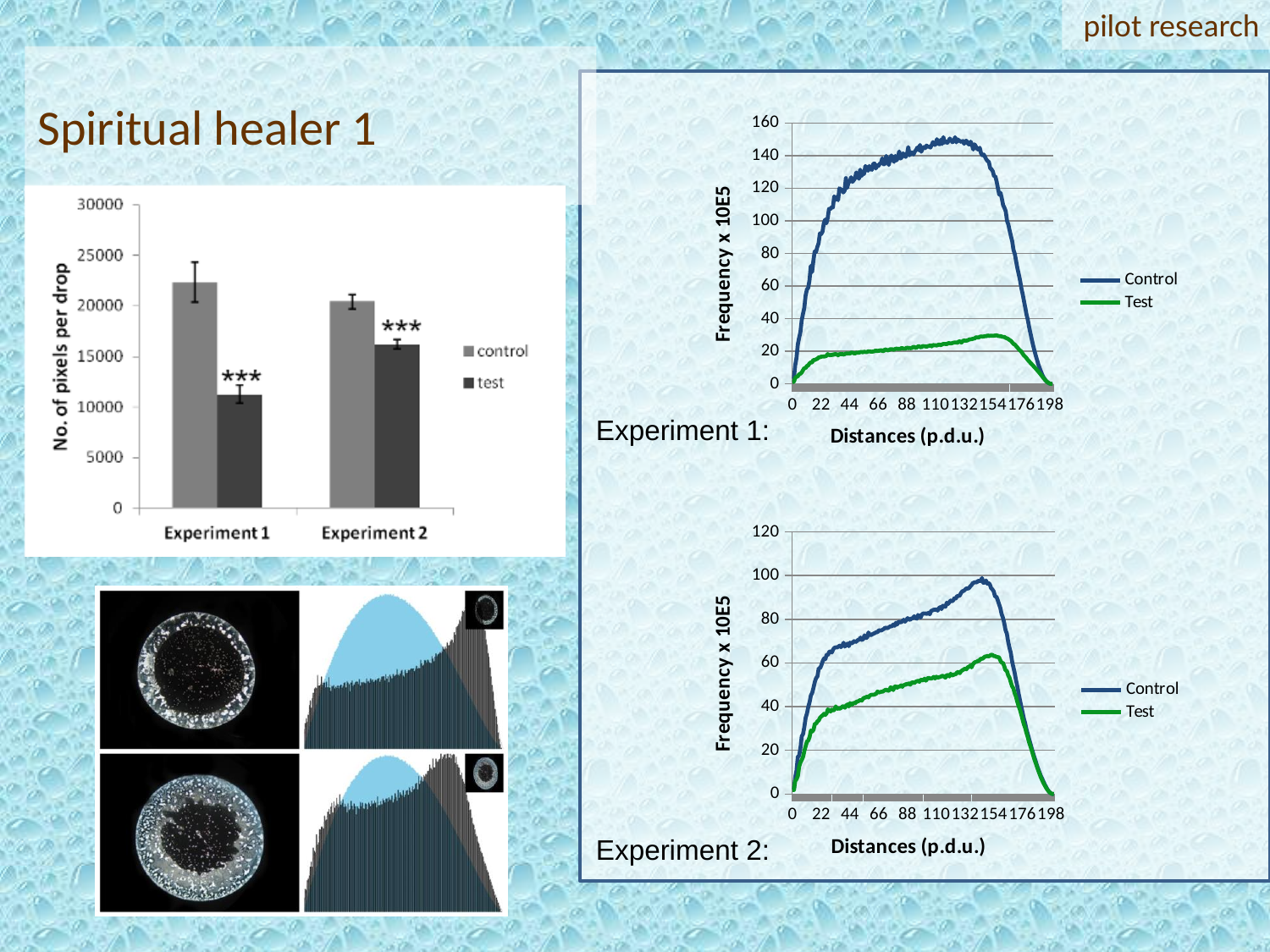
In the bar chart of number of pixels per drop, how many series does the legend list? 2 In the bar chart of number of pixels per drop, is the control value for Experiment 1 greater or less than 20000? greater In the bar chart of number of pixels per drop, is the test value for Experiment 1 greater or less than 15000? less In the bar chart of number of pixels per drop, which is larger for Experiment 2, control or test? control In the Experiment 1 line chart, is the peak of the Control line greater or less than 140? greater What kind of chart is the left-hand chart showing number of pixels per drop? bar chart In the bar chart of number of pixels per drop, which bar is the lowest? test, Experiment 1 In the Experiment 2 line chart, which series reaches the higher peak, Control or Test? Control What kind of chart is the Experiment 1 chart of Frequency x 10E5 against Distances? line chart In the Experiment 1 line chart, how many series does the legend list? 2 In the bar chart of number of pixels per drop, how many experiment categories are shown on the x axis? 2